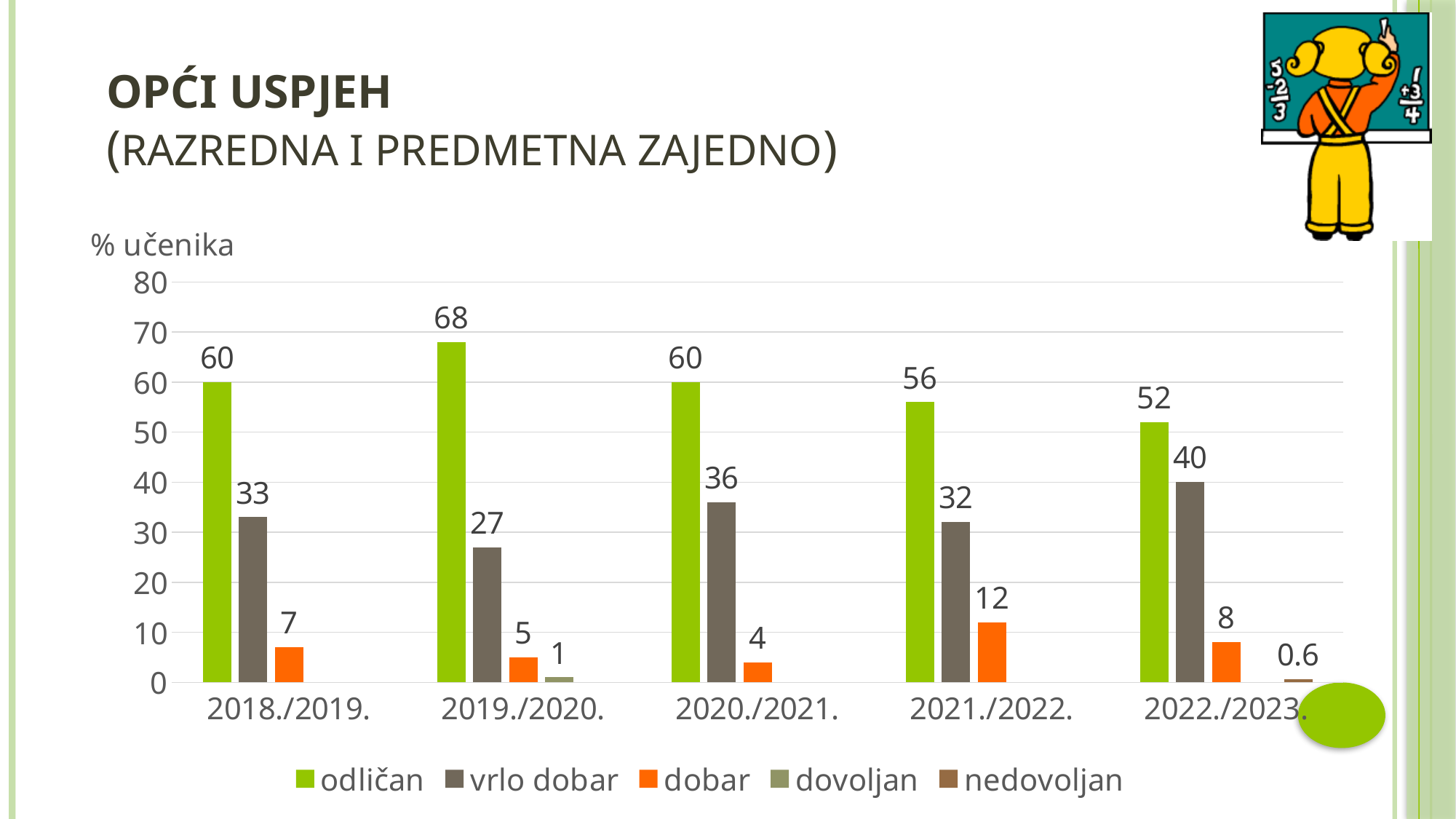
What is the value for "dobar" in 2021./2022.? 12 What is the difference between the "odličan" values for 2019./2020. and 2022./2023.? 16 What is the value for "vrlo dobar" in 2022./2023.? 40 Does the "odličan" value rise or fall from 2019./2020. to 2022./2023.? fall What is the label of the y axis? % učenika In which school year is the "odličan" value highest? 2019./2020. What kind of chart is shown on the slide? bar chart Which is larger: "dobar" in 2018./2019. or "dobar" in 2020./2021.? 2018./2019. How many series does the legend list? 5 In which school year is the "vrlo dobar" value lowest? 2019./2020. How many school years are shown on the x axis? 5 What percentage of students achieved "odličan" in 2019./2020.? 68